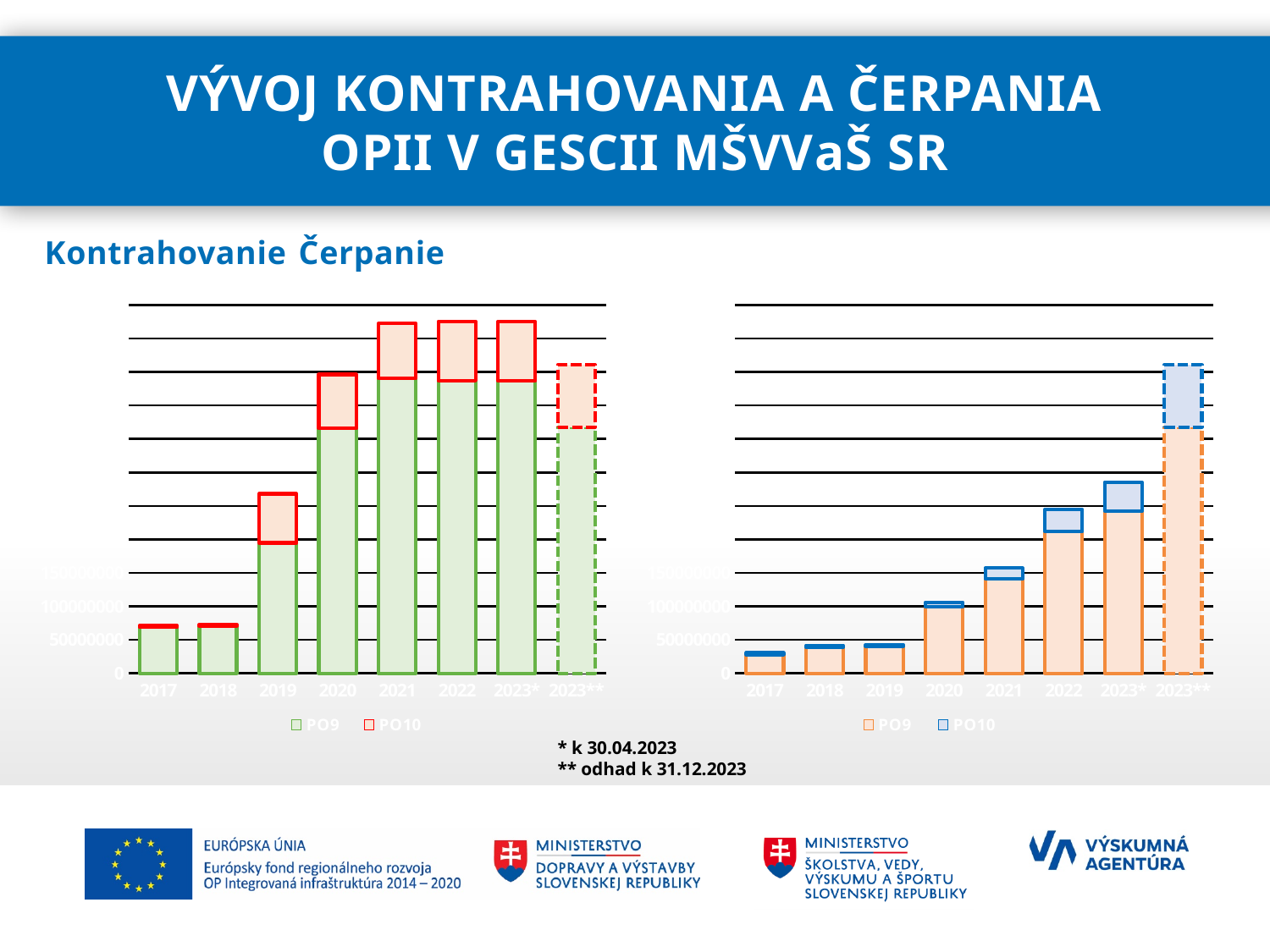
In the Čerpanie chart on the right, do the total bar values generally rise or fall from 2017 to 2023**? Rise In the Čerpanie chart on the right, which year has the highest total bar? 2023** In the Čerpanie chart on the right, which total bar is larger, 2022 or 2023**? 2023** In both charts, which year category is drawn with dashed bar outlines? 2023** In the Čerpanie chart on the right, is the total value for 2023** greater or less than 150000000? greater In the Kontrahovanie chart on the left, is the PO9 value for 2019 greater or less than 150000000? greater In the Čerpanie chart on the right, is the total value for 2017 greater or less than 50000000? less What are the two legend entries of the Kontrahovanie chart on the left? PO9 and PO10 How many year categories are shown on the x axis of the Kontrahovanie chart on the left? 8 How many series does the legend of the Čerpanie chart on the right list? 2 In the Kontrahovanie chart on the left, which total bar is larger, 2019 or 2020? 2020 What kind of chart is the Kontrahovanie chart on the left? Stacked bar chart